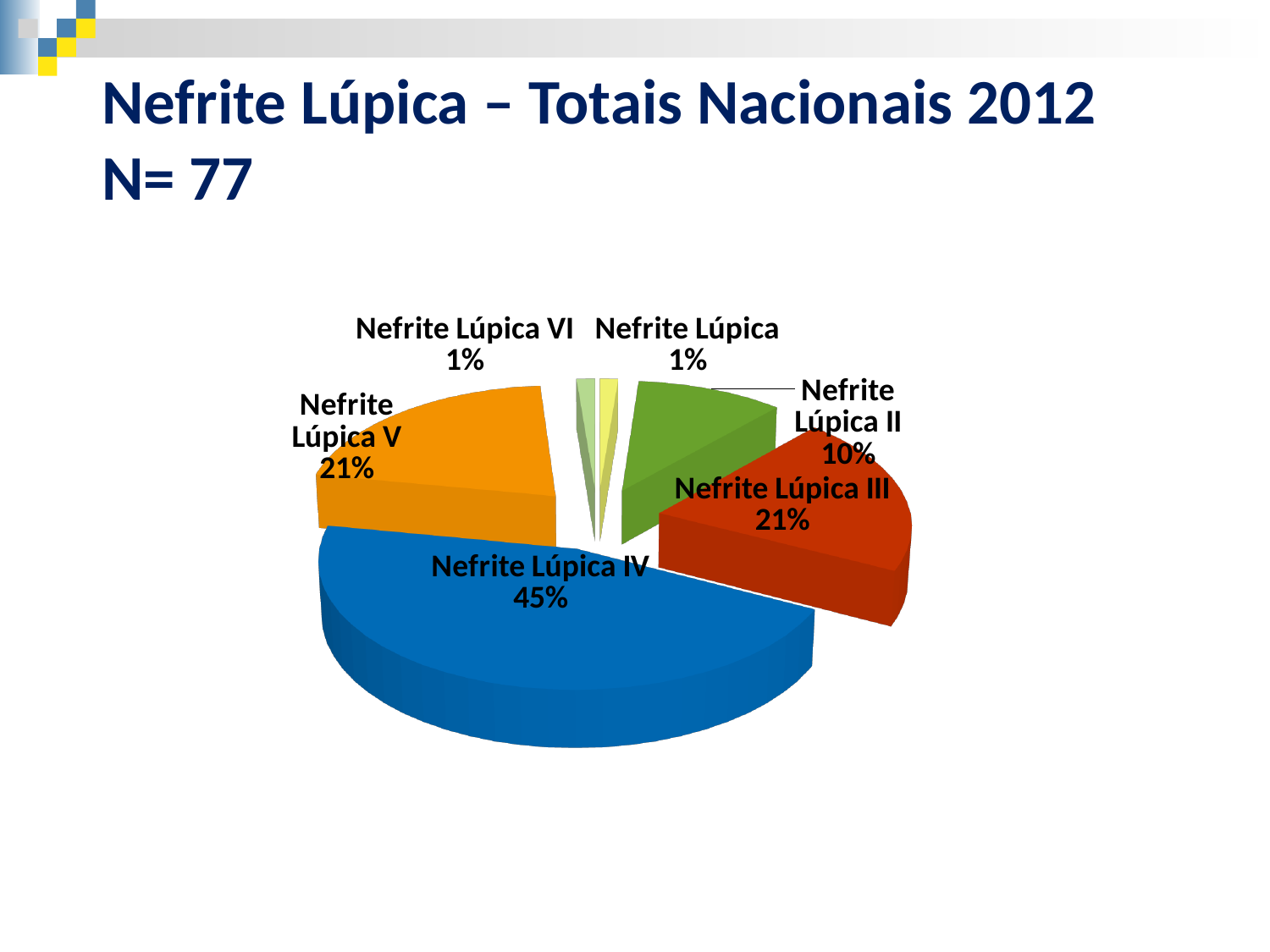
What kind of chart is shown on the slide? Pie chart Which category has the largest slice of the pie? Nefrite Lúpica IV What is the difference in percentage points between the shares of Nefrite Lúpica V and Nefrite Lúpica II? 11 percentage points What is the difference in percentage points between the shares of Nefrite Lúpica IV and Nefrite Lúpica III? 24 percentage points What share of the pie does Nefrite Lúpica II represent? 10% What share of the pie does Nefrite Lúpica VI represent? 1% Which is larger, the share for Nefrite Lúpica II or the share for Nefrite Lúpica V? Nefrite Lúpica V How many slices does the pie chart have? 6 What colour is the slice for Nefrite Lúpica IV? Blue What is the title of the slide containing the chart? Nefrite Lúpica – Totais Nacionais 2012 N= 77 What share of the pie does Nefrite Lúpica IV represent? 45%